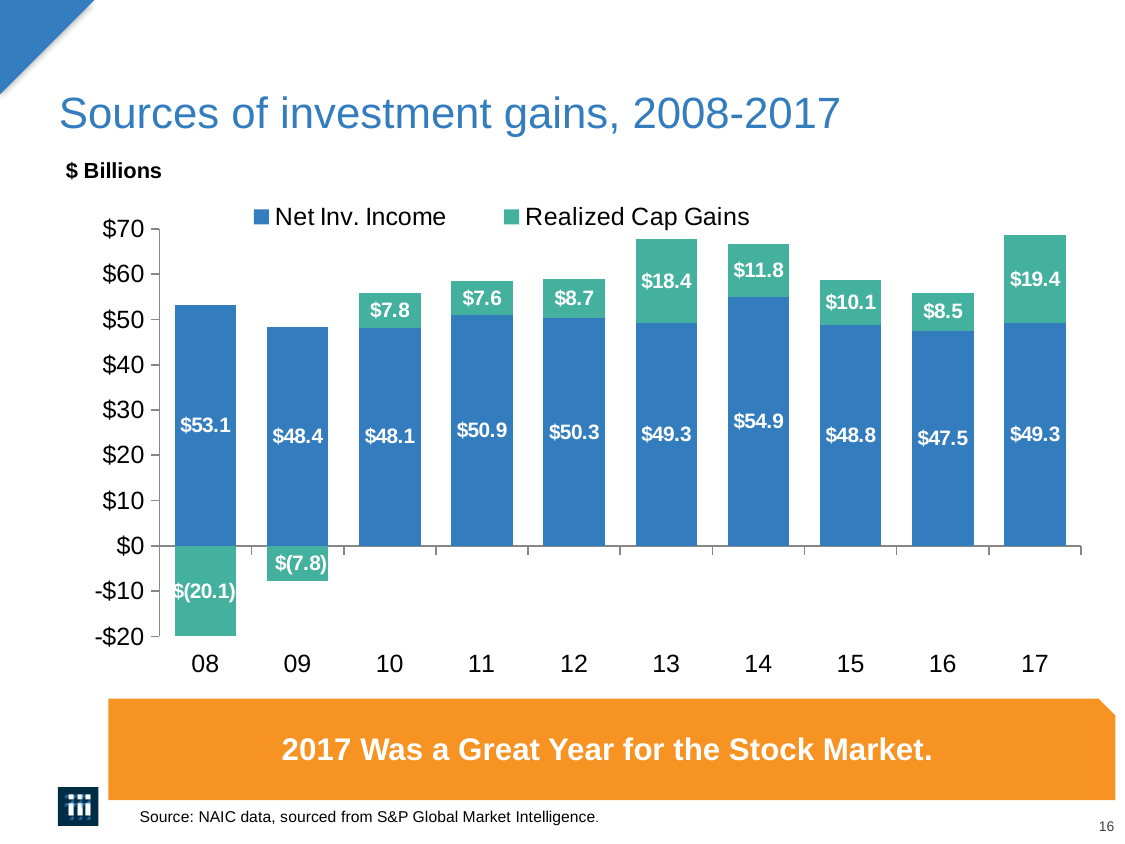
What kind of chart is shown on the slide? Stacked bar chart What is the Realized Cap Gains value for 2017? $19.4 What is the difference between Realized Cap Gains in 2017 and in 2013? $1.0 Which year has the highest Net Inv. Income? 14 Which year has the highest Realized Cap Gains? 17 What is the Net Inv. Income value for 2014? $54.9 What is the total of the stacked bar for 2017 (Net Inv. Income plus Realized Cap Gains)? $68.7 What is the Realized Cap Gains value for 2008? $(20.1) Which year has the lowest Net Inv. Income? 16 How many years are shown on the x axis? 10 Which is larger, Net Inv. Income in 2014 or in 2016? 2014 How many series does the legend list? 2